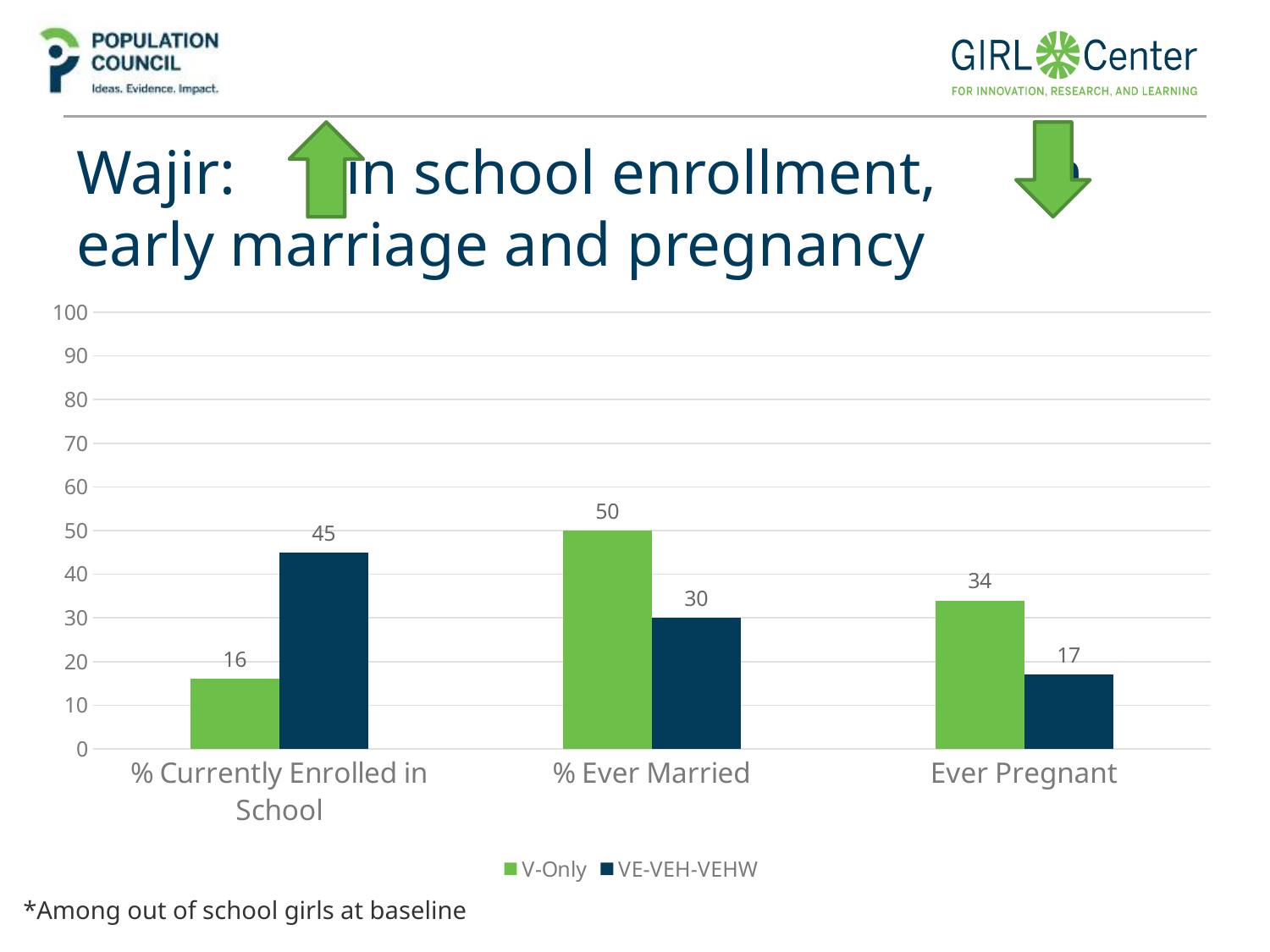
What is the difference between the V-Only and VE-VEH-VEHW values for Ever Pregnant? 17 Which category has the lowest VE-VEH-VEHW value? Ever Pregnant What is the difference between the VE-VEH-VEHW and V-Only values for % Currently Enrolled in School? 29 What is the V-Only value for % Currently Enrolled in School? 16 What is the VE-VEH-VEHW value for % Ever Married? 30 Which category has the highest V-Only value? % Ever Married What kind of chart is shown on the slide? Bar chart How many series does the legend list? 2 Is the VE-VEH-VEHW value for % Currently Enrolled in School greater or less than 40? greater What is the VE-VEH-VEHW value for Ever Pregnant? 17 How many categories are shown on the x axis? 3 For % Ever Married, which series has the larger value, V-Only or VE-VEH-VEHW? V-Only